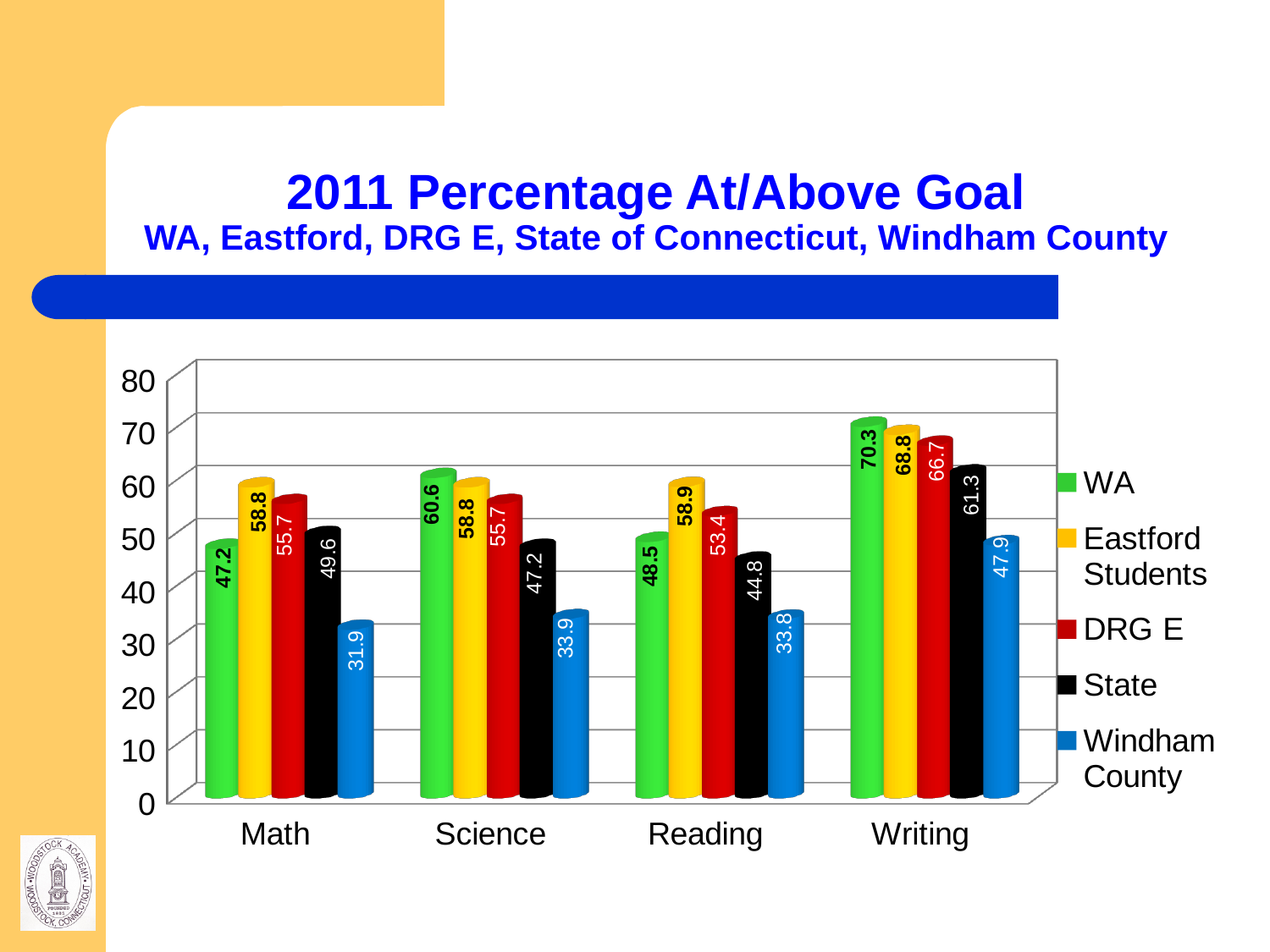
How many subject categories are shown on the x axis? 4 In which subject does WA have its highest value? Writing What is the value for Windham County in Math? 31.9 What is the value for State in Reading? 44.8 What kind of chart is shown on the slide? Bar chart What is the value for WA in Writing? 70.3 What is the difference between the Eastford Students value and the WA value in Math? 11.6 What is the value for DRG E in Science? 55.7 Which series has the lowest value in Reading? Windham County What colour are the bars for Windham County? Blue Which is larger in Science, the WA value or the Eastford Students value? WA How many series does the legend list? 5